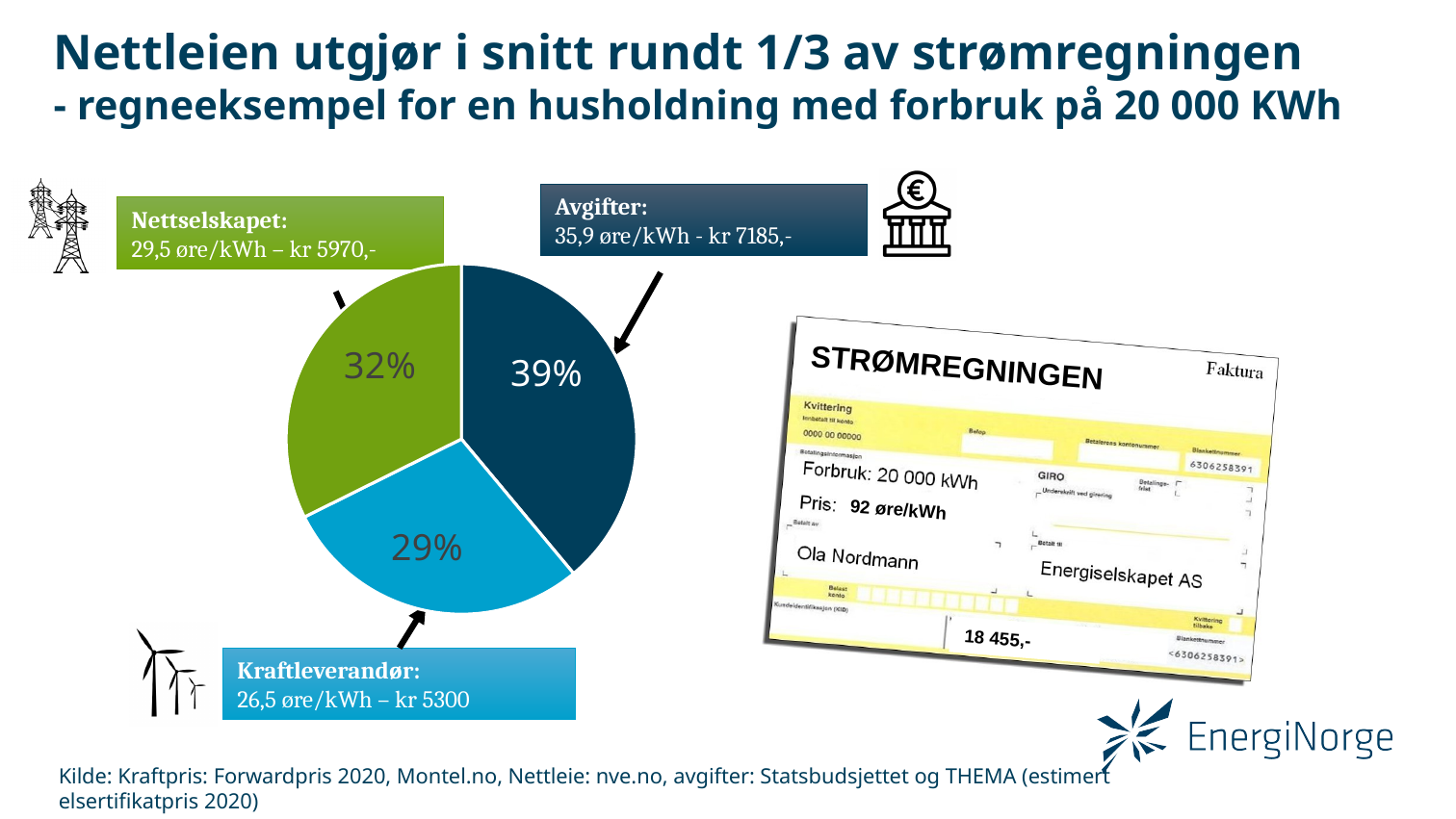
What price per kWh and total amount are given for Nettselskapet in its label box? 29,5 øre/kWh – kr 5970,- What is the difference in percentage points between the Avgifter slice and the Kraftleverandør slice? 10 How many slices does the pie chart have? 3 What colour is the Avgifter slice of the pie chart? dark blue What share of the pie does Kraftleverandør account for? 29% Which is larger, the Nettselskapet slice or the Kraftleverandør slice? Nettselskapet Which slice of the pie chart is the smallest? Kraftleverandør Which slice of the pie chart is the largest? Avgifter What price per kWh and total amount are given for Avgifter in its label box? 35,9 øre/kWh - kr 7185,- What share of the pie does Nettselskapet account for? 32% What share of the pie does Avgifter (taxes) account for? 39% What kind of chart is shown on the slide? pie chart